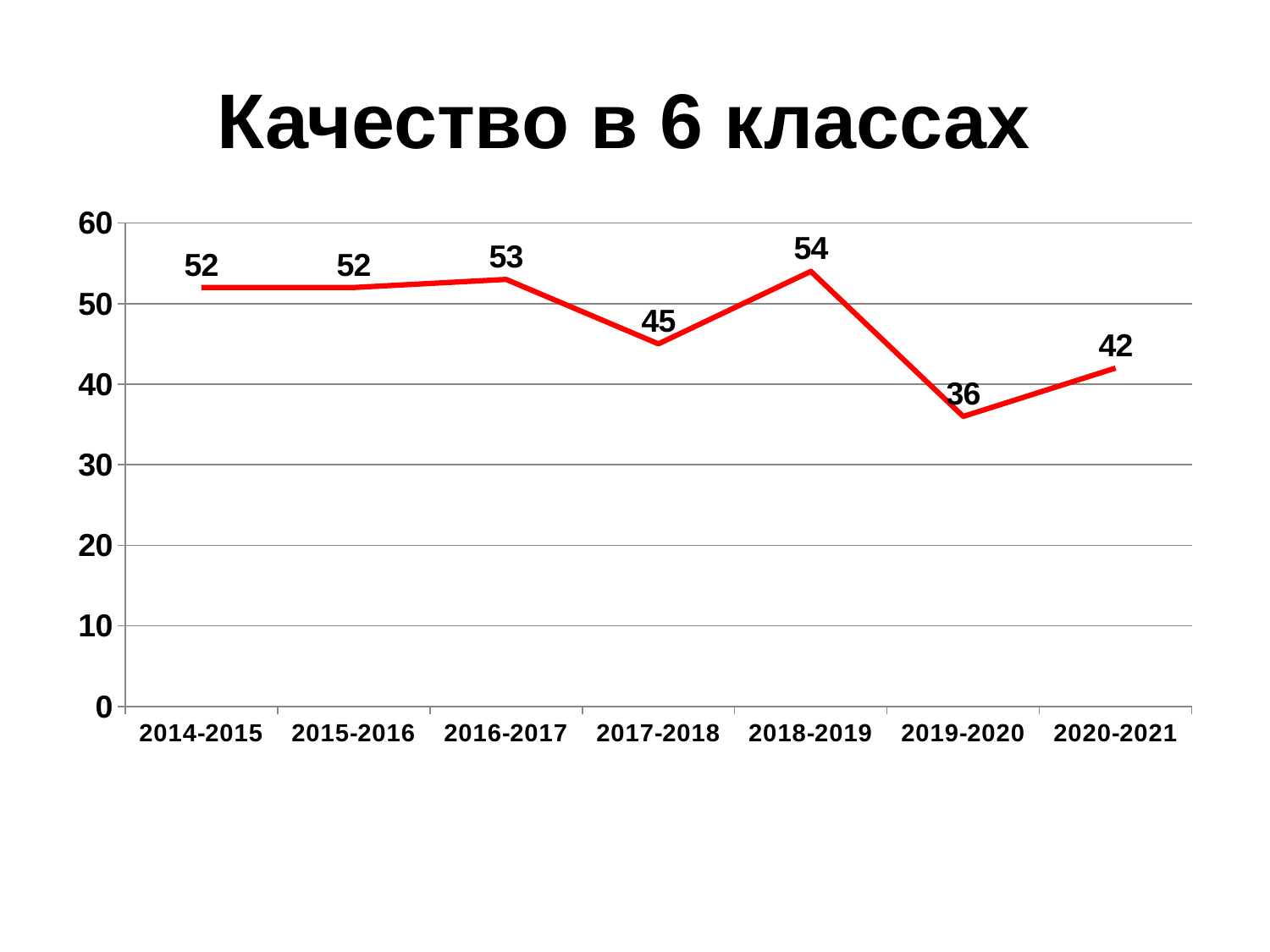
What is the value for 2020-2021? 42 What is the title of the chart? Качество в 6 классах How many years are shown on the x axis? 7 What kind of chart is this? line chart What is the value for 2017-2018? 45 Which year has the lowest value? 2019-2020 Which is larger, the value for 2016-2017 or the value for 2017-2018? 2016-2017 What is the value for 2019-2020? 36 What is the value for 2014-2015? 52 What is the difference between the values for 2018-2019 and 2019-2020? 18 Is the value for 2019-2020 greater or less than 40? less Which year has the highest value? 2018-2019